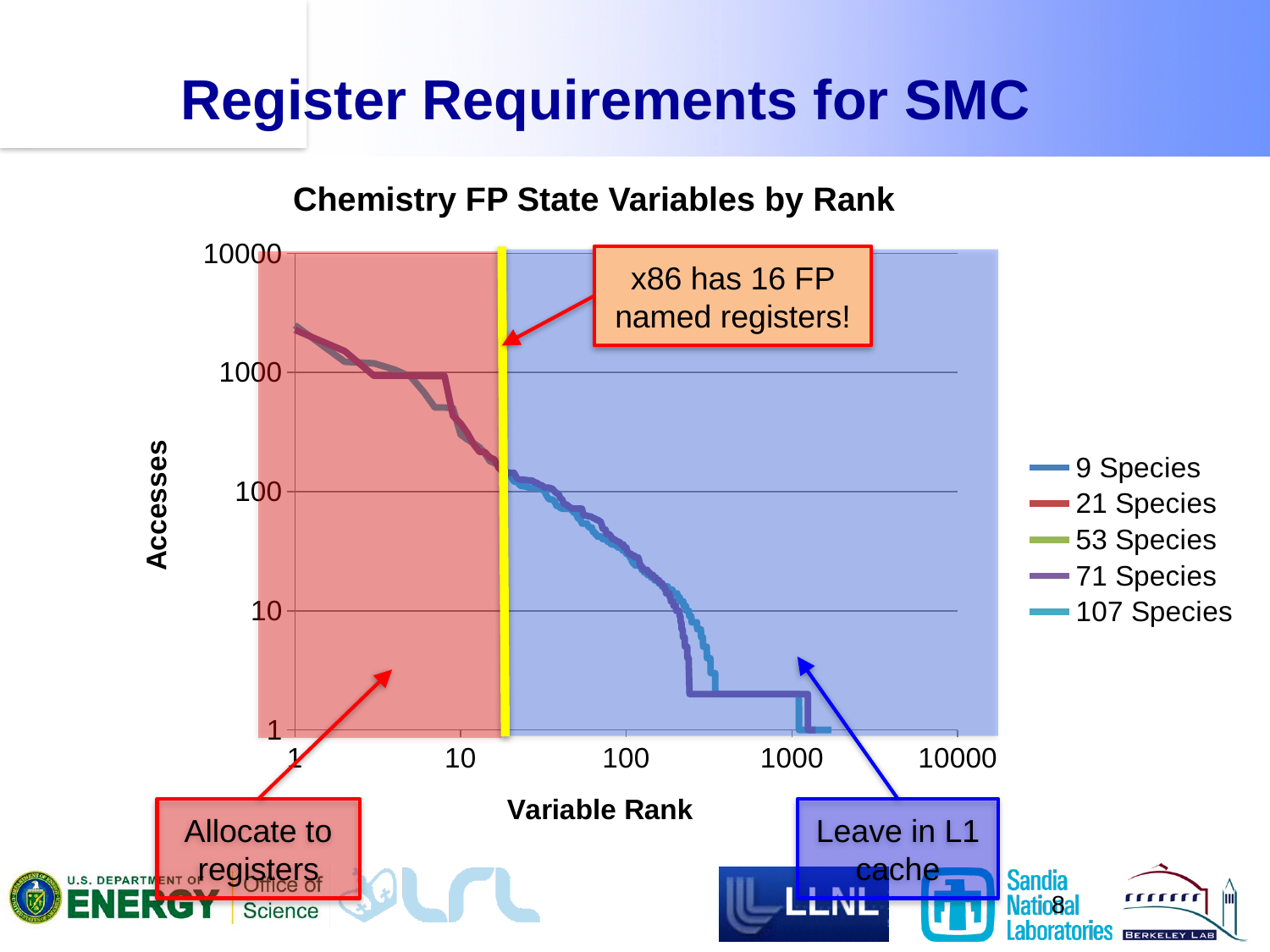
What is the highest value shown on the y axis (Accesses)? 10000 What is the label of the x axis? Variable Rank How many series does the chart's legend list? 5 Is the number of accesses at variable rank 1000 greater or less than 10? less Which is larger, the number of accesses at variable rank 1 or at variable rank 100? variable rank 1 Is the number of accesses at variable rank 100 greater or less than 100? less Do the accesses rise or fall as variable rank increases along the x axis? fall What kind of chart is shown on the slide? line chart What is the title of the chart? Chemistry FP State Variables by Rank